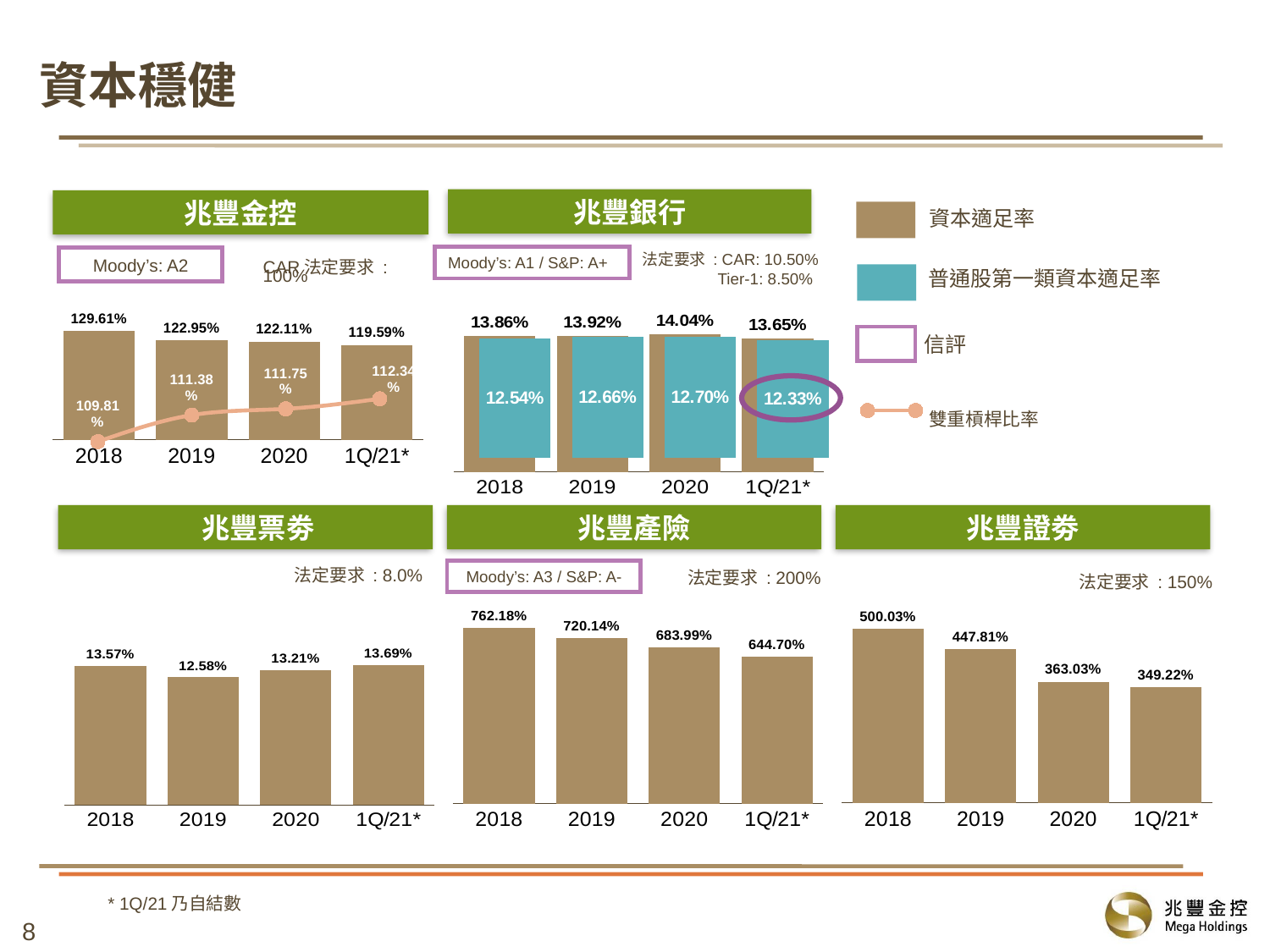
What kind of chart is the 兆豐票券 chart? bar chart In the 兆豐銀行 chart, which year has the highest 資本適足率? 2020 In the 兆豐銀行 chart, what is the difference between the 資本適足率 and the 普通股第一類資本適足率 for 1Q/21*? 1.32% In the 兆豐票券 chart, what is the value for 1Q/21*? 13.69% In the 兆豐金控 chart, what is the 雙重槓桿比率 value for 1Q/21*? 112.34% In the 兆豐票券 chart, which period has the lowest value? 2019 In the 兆豐金控 chart, what is the 資本適足率 value for 2018? 129.61% In the 兆豐銀行 chart, what is the 普通股第一類資本適足率 value for 2020? 12.70% In the 兆豐產險 chart, do the values rise or fall from 2018 to 1Q/21*? fall In the 兆豐證券 chart, which is larger, the value for 2020 or the value for 1Q/21*? 2020 How many periods are shown on the x axis of the 兆豐證券 chart? 4 In the 兆豐產險 chart, what is the difference between the 2018 and 2019 values? 42.04%